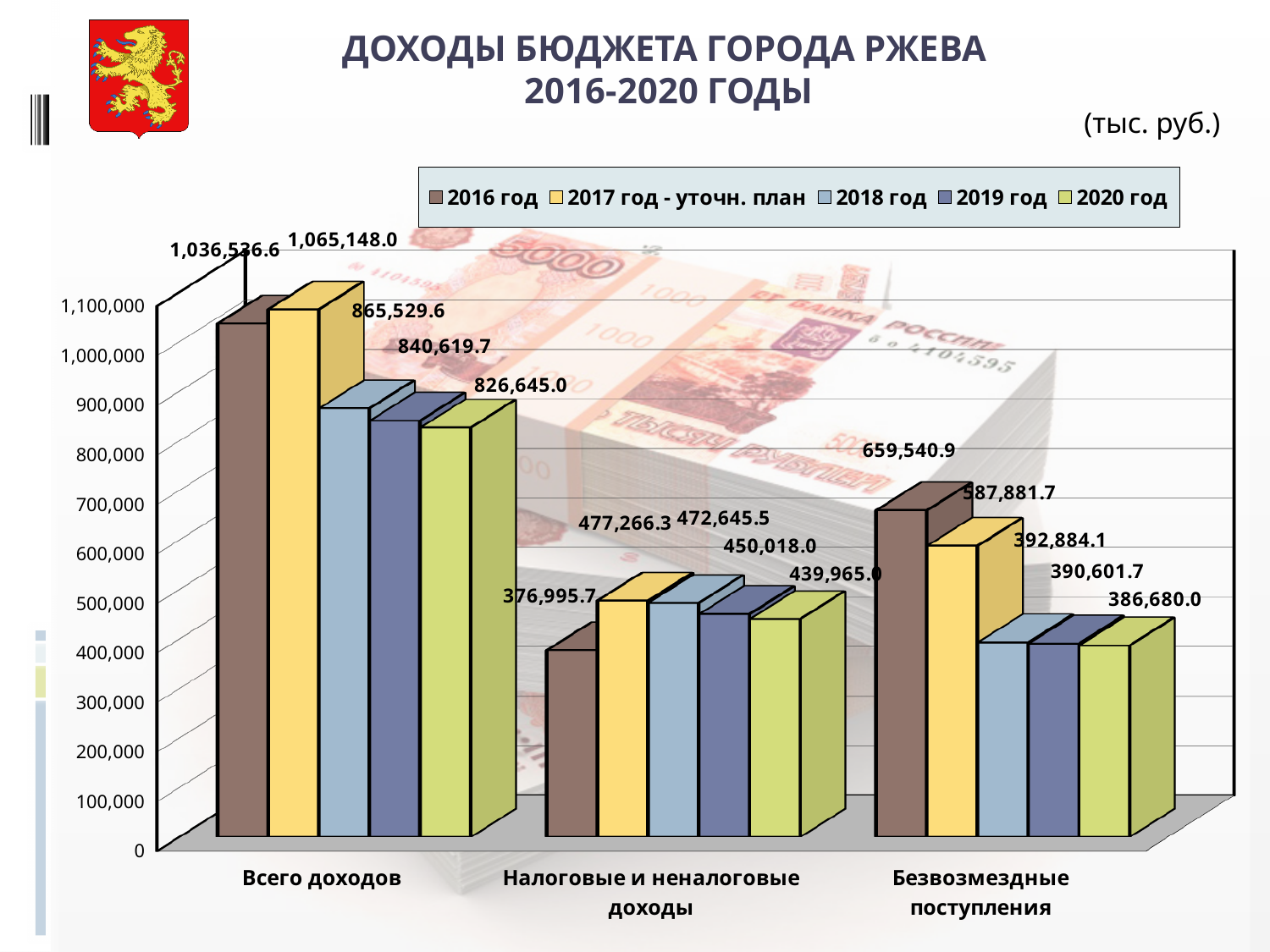
What is the value for 2020 год in the category Безвозмездные поступления? 386,680.0 In the category Безвозмездные поступления, which year has the lowest value? 2020 год Do the values for Безвозмездные поступления rise or fall from 2016 год to 2020 год? Fall In the category Налоговые и неналоговые доходы, which year has the highest value? 2017 год - уточн. план What kind of chart is shown on the slide? Bar chart For 2018 год, which is larger: Налоговые и неналоговые доходы or Безвозмездные поступления? Налоговые и неналоговые доходы In what units are the values on the chart given? тыс. руб. How many categories are shown on the x axis? 3 How many series does the legend list? 5 What is the value for 2016 год in the category Налоговые и неналоговые доходы? 376,995.7 What is the value for 2017 год - уточн. план in the category Всего доходов? 1,065,148.0 What is the difference between the 2016 год and 2020 год values for Безвозмездные поступления? 272,860.9